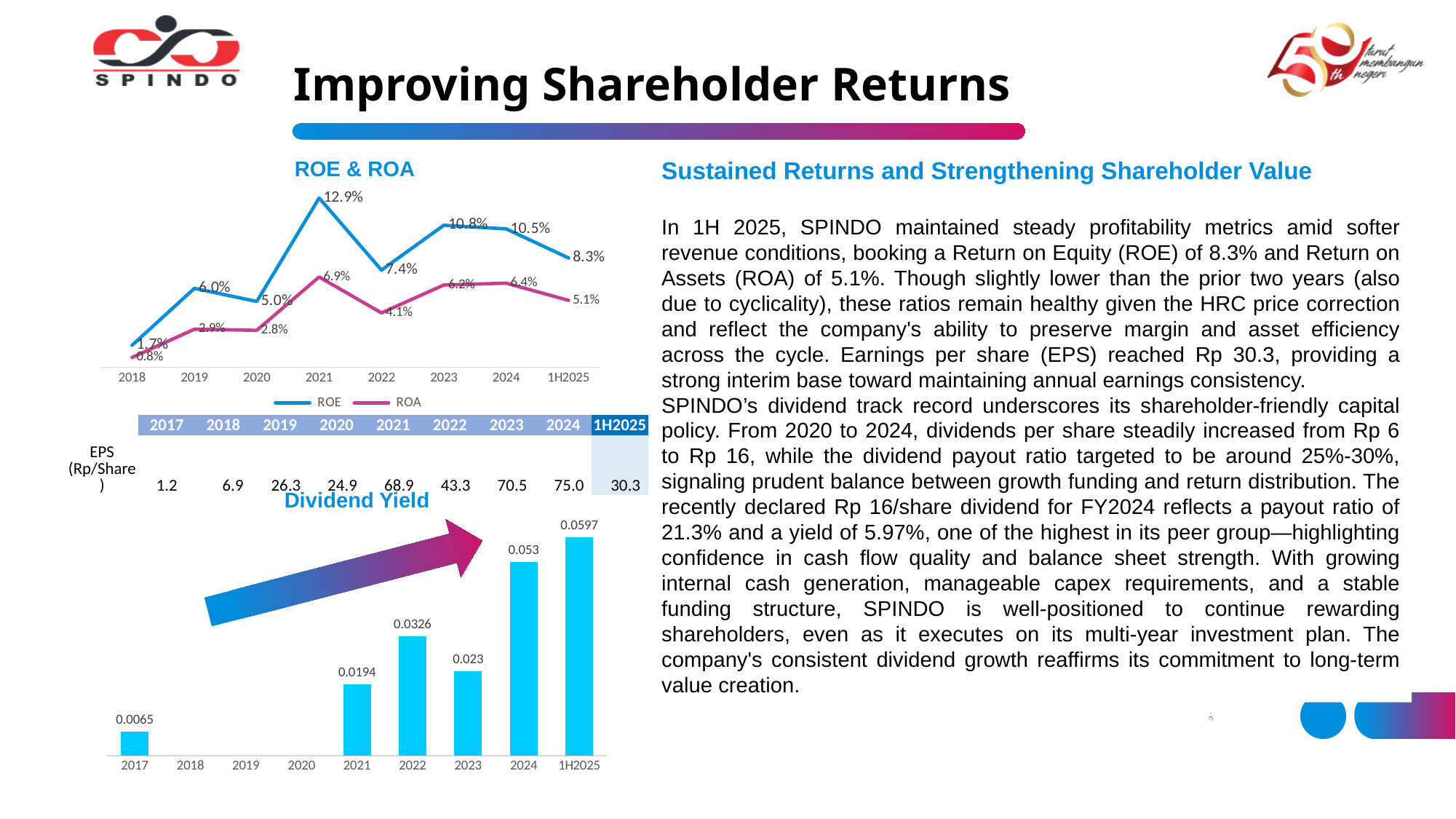
What type of chart is the ROE & ROA chart? Line chart In the ROE & ROA chart, which year has the lowest ROA? 2018 What type of chart is the Dividend Yield chart? Bar chart In the Dividend Yield chart, what is the difference between the 1H2025 value and the 2024 value? 0.0067 In the Dividend Yield chart, which period has the highest value? 1H2025 In the Dividend Yield chart, is the value for 2022 larger or smaller than the value for 2023? Larger In the ROE & ROA chart, what is the ROE value for 2021? 12.9% In the Dividend Yield chart, what is the value for 2024? 0.053 In the ROE & ROA chart, which year has the highest ROE? 2021 In the ROE & ROA chart, what is the difference between ROE and ROA in 2023? 4.6% In the ROE & ROA chart, how many series does the legend list? 2 In the ROE & ROA chart, what is the ROA value for 1H2025? 5.1%